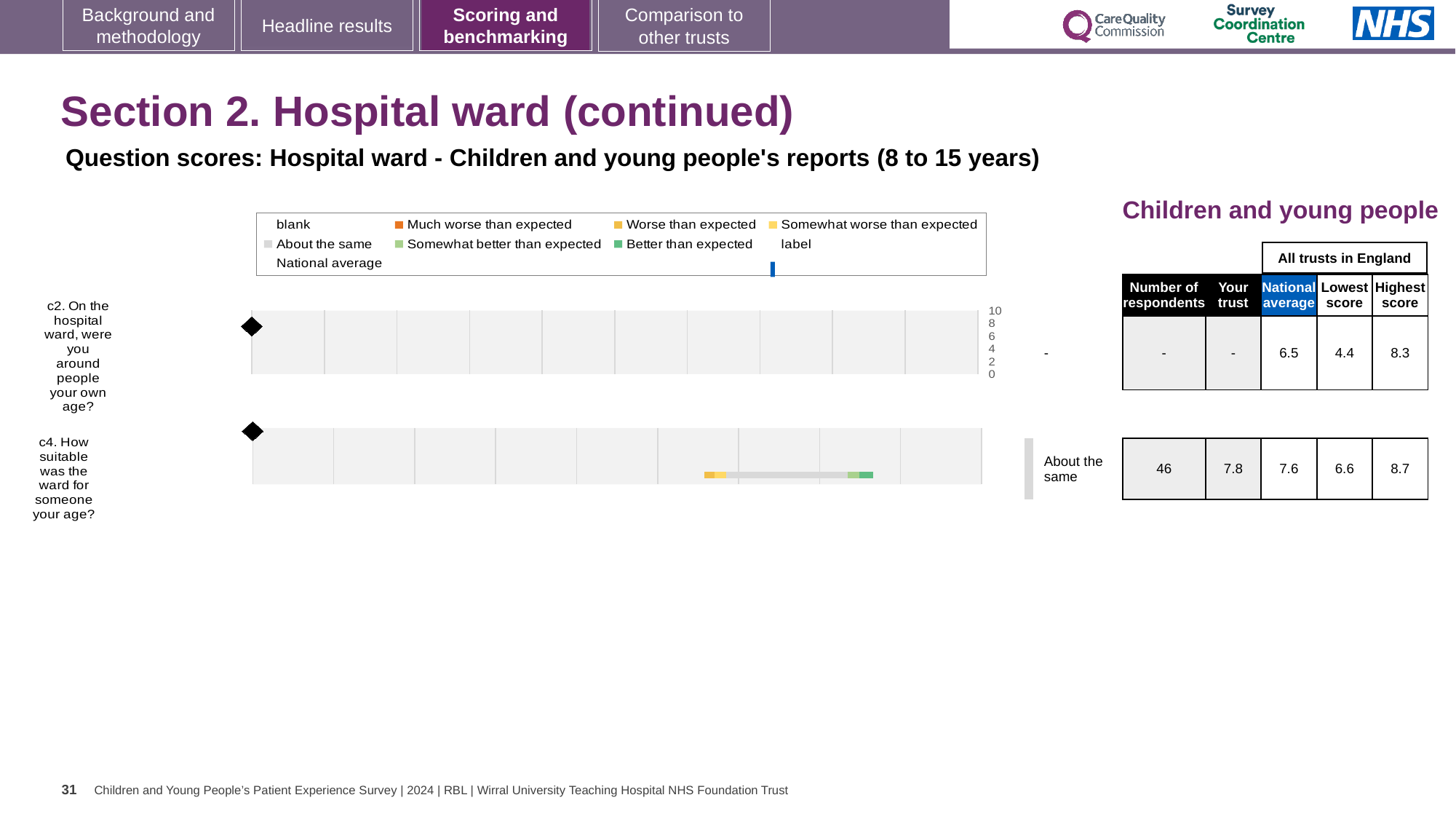
What is the difference between the national average for c4 and the national average for c2? 1.1 What kind of chart is used to show the c4 question score? bar chart What is the national average score for c4 (How suitable was the ward for someone your age?)? 7.6 What is the national average score for c2 (On the hospital ward, were you around people your own age?)? 6.5 What is the highest score among all trusts in England for c4? 8.7 For c4, which is larger: the 'Your trust' score or the national average? Your trust What is the lowest score among all trusts in England for c4? 6.6 What benchmark category is shown for c4 (How suitable was the ward for someone your age?)? About the same What is the highest value shown on the chart's score axis? 10 What is the 'Your trust' score for c4 (How suitable was the ward for someone your age?)? 7.8 How many respondents answered c4 (How suitable was the ward for someone your age?)? 46 What is the difference between the highest and lowest trust scores for c4? 2.1